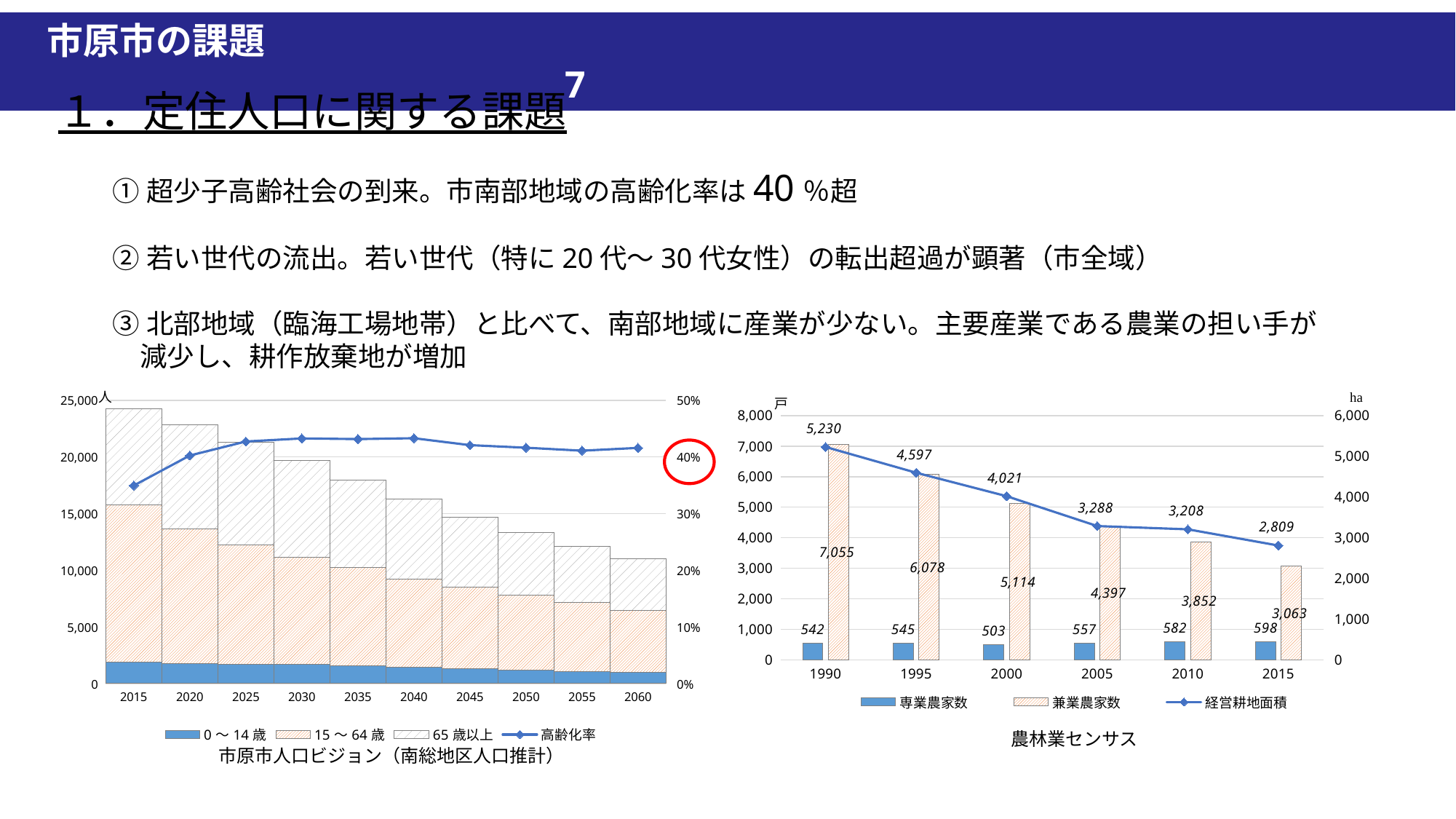
In the right chart (農林業センサス), how does 兼業農家数 change from 1990 to 2015? It falls In the right chart (農林業センサス), what is the value of 兼業農家数 in 1990? 7,055 In the right chart (農林業センサス), which is larger: 経営耕地面積 in 2005 or in 2010? 2005 In the right chart (農林業センサス), what is the value of 経営耕地面積 in 2015? 2,809 In the left chart (市原市人口ビジョン), is the 高齢化率 value for 2060 greater or less than 30%? greater In the right chart (農林業センサス), what is the difference between 兼業農家数 in 1990 and in 2015? 3,992 In the right chart (農林業センサス), how many series does the legend list? 3 In the right chart (農林業センサス), what is the value of 専業農家数 in 2005? 557 In the right chart (農林業センサス), which year has the highest value of 兼業農家数? 1990 In the left chart (市原市人口ビジョン), how many series does the legend list? 4 In the left chart (市原市人口ビジョン), how many years are shown on the x axis? 10 In the right chart (農林業センサス), which year has the lowest value of 専業農家数? 2000